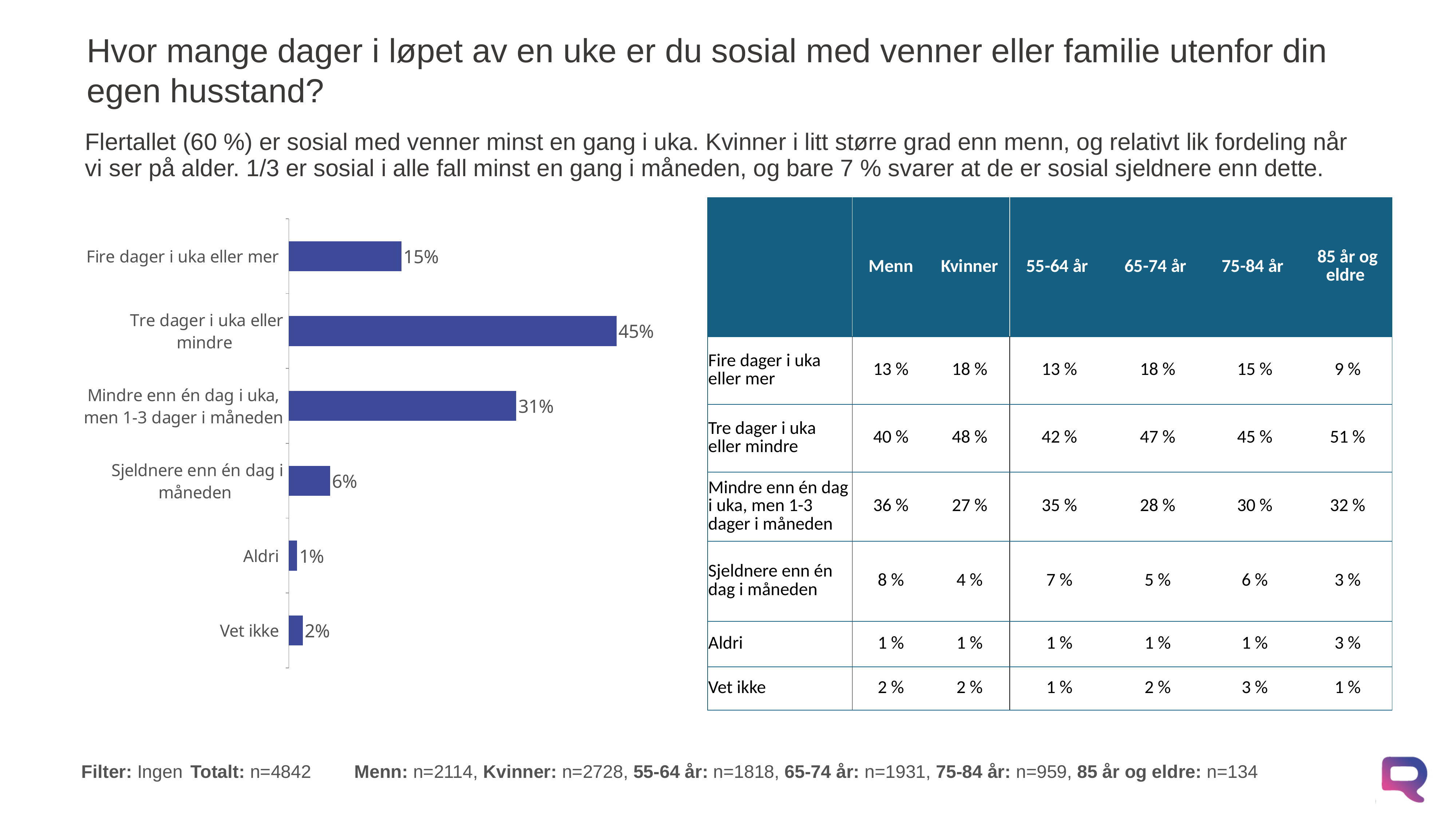
How many categories are shown in the bar chart? 6 In the bar chart, which is larger: the value for "Fire dager i uka eller mer" or the value for "Sjeldnere enn én dag i måneden"? Fire dager i uka eller mer Which category has the lowest value in the bar chart? Aldri What is the value for "Vet ikke" in the bar chart? 2% Which category has the highest value in the bar chart? Tre dager i uka eller mindre What is the value for "Sjeldnere enn én dag i måneden" in the bar chart? 6% What is the difference between the values for "Tre dager i uka eller mindre" and "Mindre enn én dag i uka, men 1-3 dager i måneden" in the bar chart? 14% What is the difference between the values for "Vet ikke" and "Aldri" in the bar chart? 1% What is the value for "Tre dager i uka eller mindre" in the bar chart? 45% What is the value for "Fire dager i uka eller mer" in the bar chart? 15% What is the value for "Mindre enn én dag i uka, men 1-3 dager i måneden" in the bar chart? 31% What kind of chart is shown on the left of the slide? Bar chart